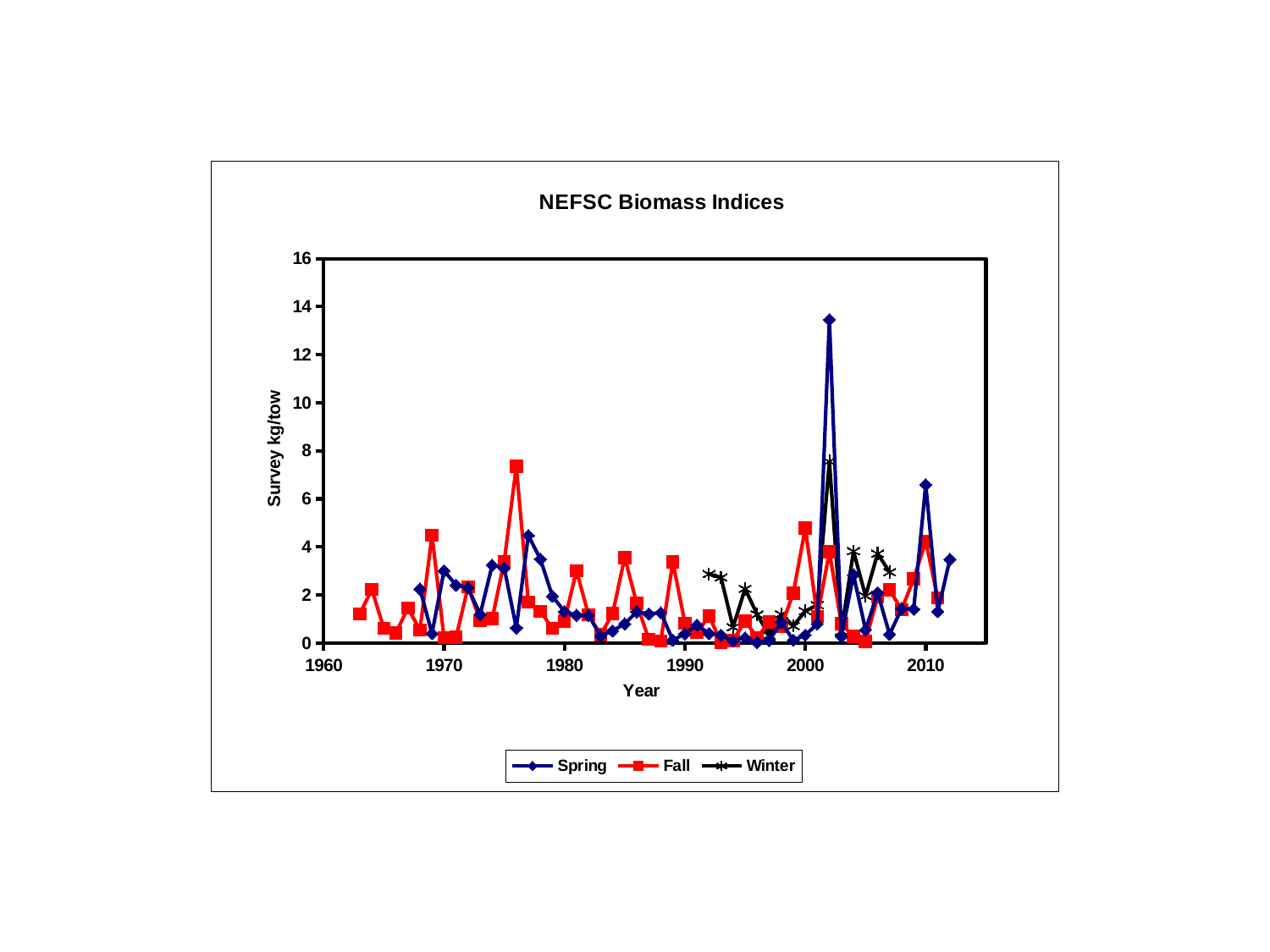
What kind of chart is shown on the slide? line chart Is the Winter value in 2002 greater or less than 6? greater What is the title of the chart? NEFSC Biomass Indices Is the Fall value in 1990 greater or less than 2? less Which series reaches the highest value on the chart? Spring How many series does the legend list? 3 Is the Spring value in 2010 greater or less than 4? greater What is the label of the y axis? Survey kg/tow In 1976, which is larger, the Fall value or the Spring value? Fall In 2002, which is larger, the Spring value or the Fall value? Spring